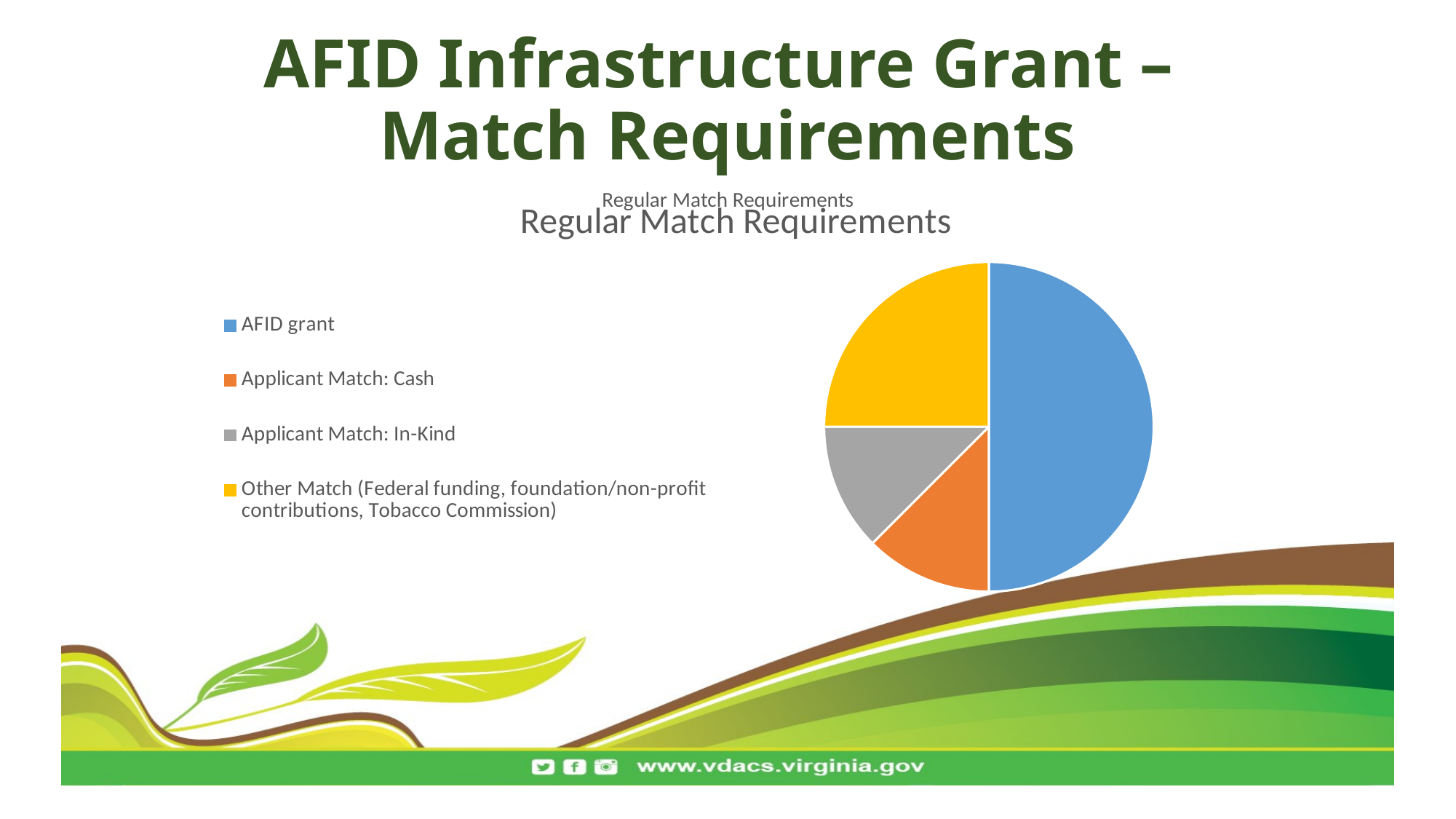
What kind of chart is shown on the slide? pie chart What colour is the AFID grant slice in the pie chart? blue Which slice is larger, AFID grant or Other Match (Federal funding, foundation/non-profit contributions, Tobacco Commission)? AFID grant How many entries does the legend of the pie chart list? 4 Which category has the largest slice of the pie chart? AFID grant What is the title of the pie chart? Regular Match Requirements How many slices does the pie chart have? 4 Which slice is larger, AFID grant or Applicant Match: In-Kind? AFID grant Which slice is larger, Other Match (Federal funding, foundation/non-profit contributions, Tobacco Commission) or Applicant Match: Cash? Other Match (Federal funding, foundation/non-profit contributions, Tobacco Commission)